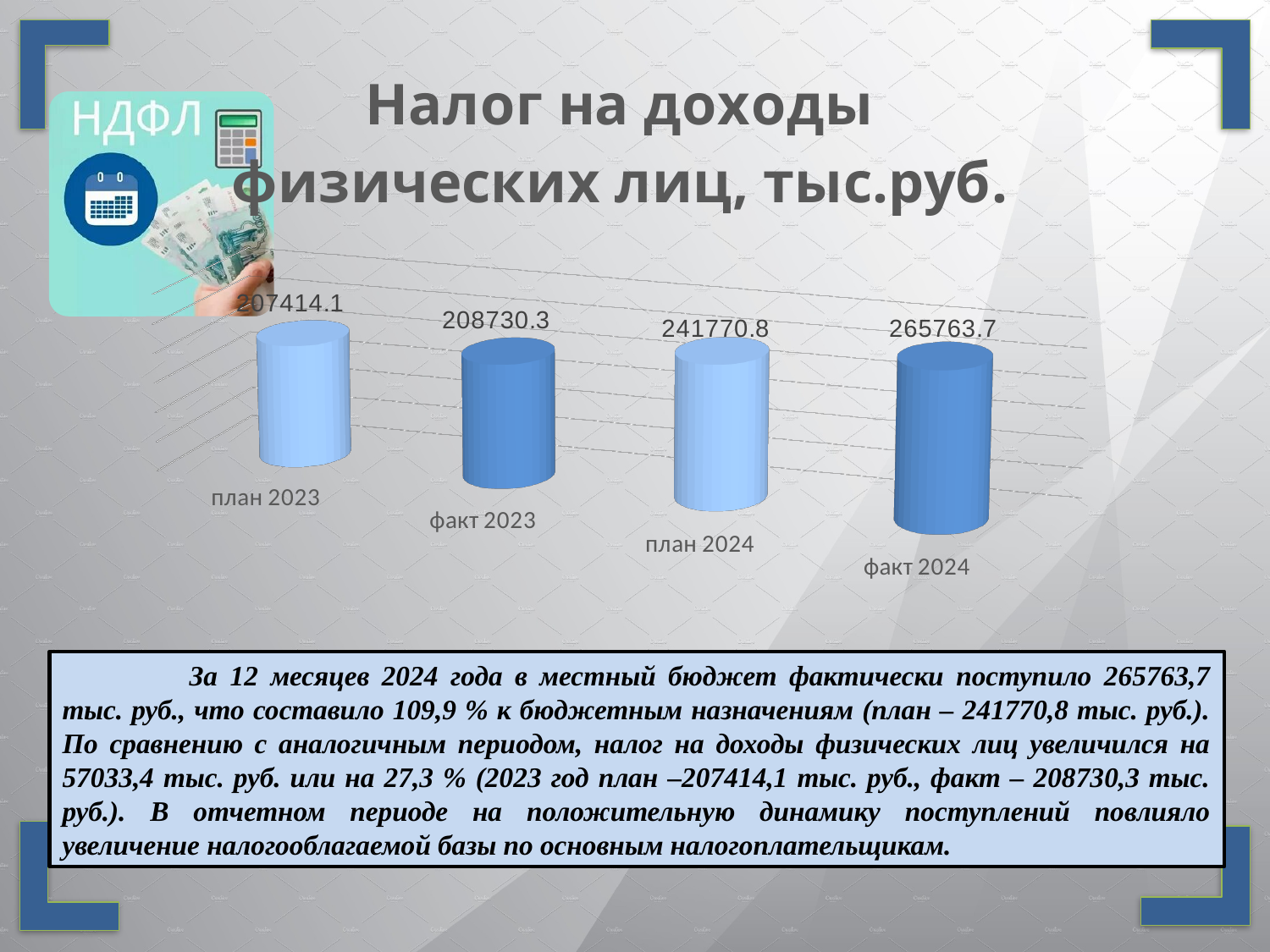
Which category has the lowest value? план 2023 Which is larger, план 2024 or факт 2024? факт 2024 What is the value for факт 2023? 208730.3 How many categories are shown in the chart? 4 What is the difference between факт 2024 and план 2024? 23992.9 What is the difference between факт 2024 and факт 2023? 57033.4 Which category has the highest value? факт 2024 Do the values rise or fall from план 2023 to факт 2024? rise What is the value for план 2023? 207414.1 What is the value for факт 2024? 265763.7 What is the value for план 2024? 241770.8 What kind of chart is shown on the slide? bar chart